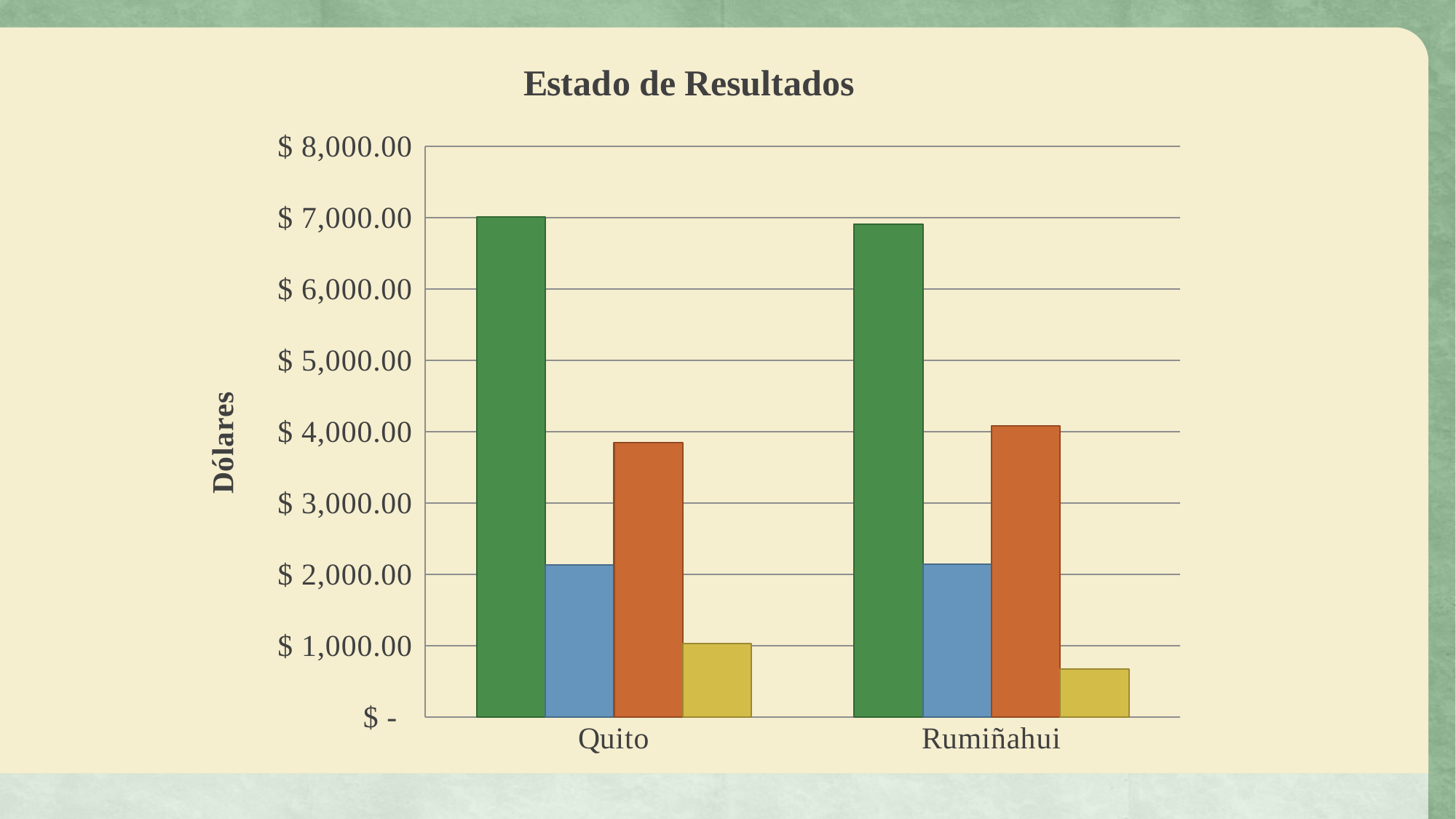
What is the label on the vertical axis of the chart? Dólares Is the value of the orange bar for Rumiñahui greater or less than $ 3,000.00? greater What kind of chart is shown on the slide? bar chart What is the title of the chart? Estado de Resultados Is the yellow bar larger for Quito or for Rumiñahui? Quito Is the value of the yellow bar for Rumiñahui greater or less than $ 1,000.00? less Which coloured bar is the highest for Rumiñahui? green Is the value of the orange bar for Quito greater or less than $ 4,000.00? less How many categories are shown on the x axis of the chart? 2 How many bars are plotted for the Quito category? 4